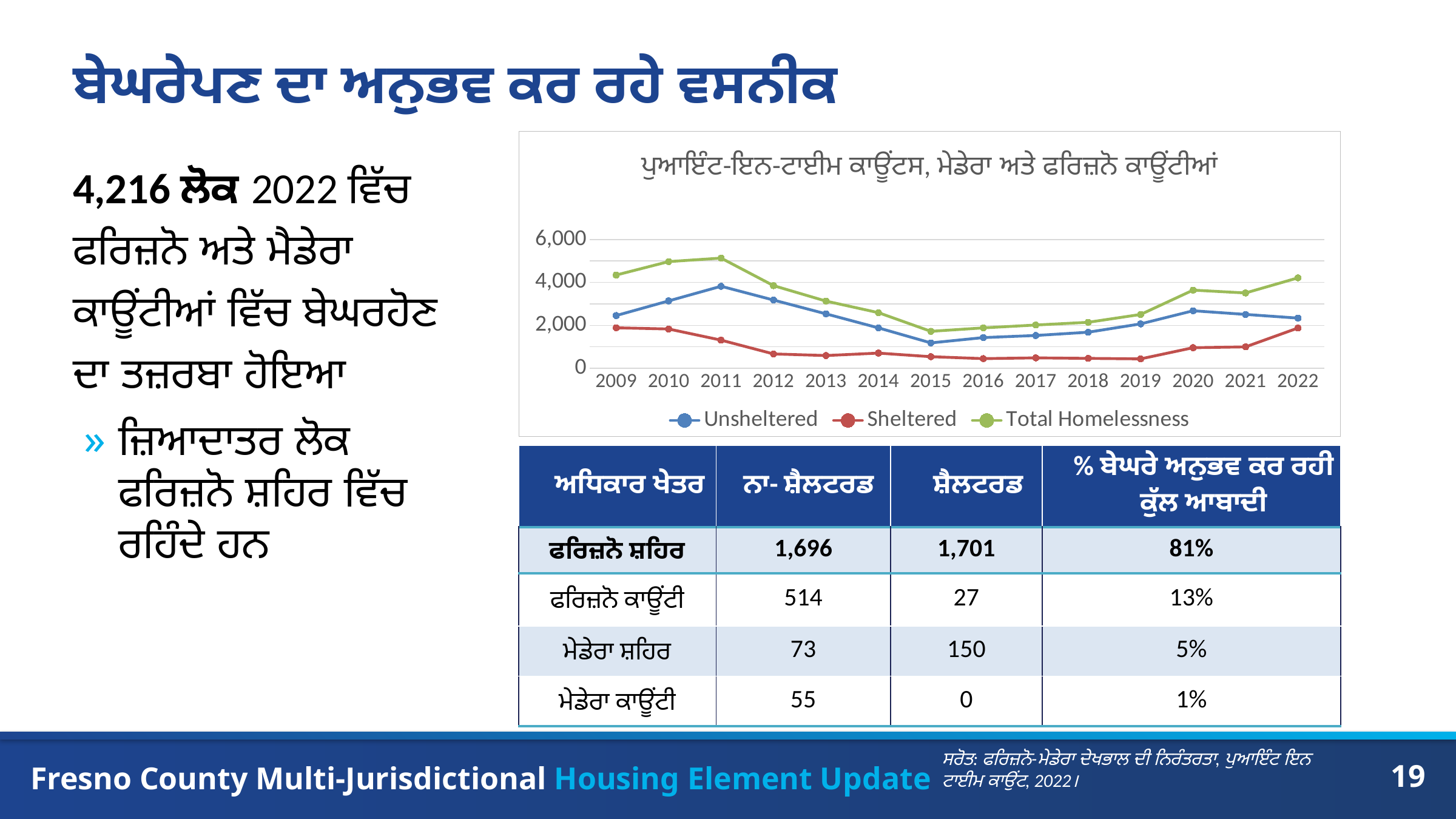
In which year is the Unsheltered line at its highest? 2011 How many series does the chart legend list? 3 Is the Total Homelessness value for 2011 greater or less than 4,000? greater Which is larger in 2011, the Unsheltered value or the Sheltered value? Unsheltered What colour is the Sheltered line in the chart? red How many years are shown along the x axis of the chart? 14 What kind of chart is shown on the slide? line chart Is the Unsheltered value for 2015 greater or less than 2,000? less Is the Sheltered value for 2016 greater or less than 1,000? less Does the Total Homelessness line rise or fall from 2011 to 2015? fall Which series is drawn in green in the chart? Total Homelessness Which is larger for Total Homelessness, the value in 2020 or the value in 2015? 2020